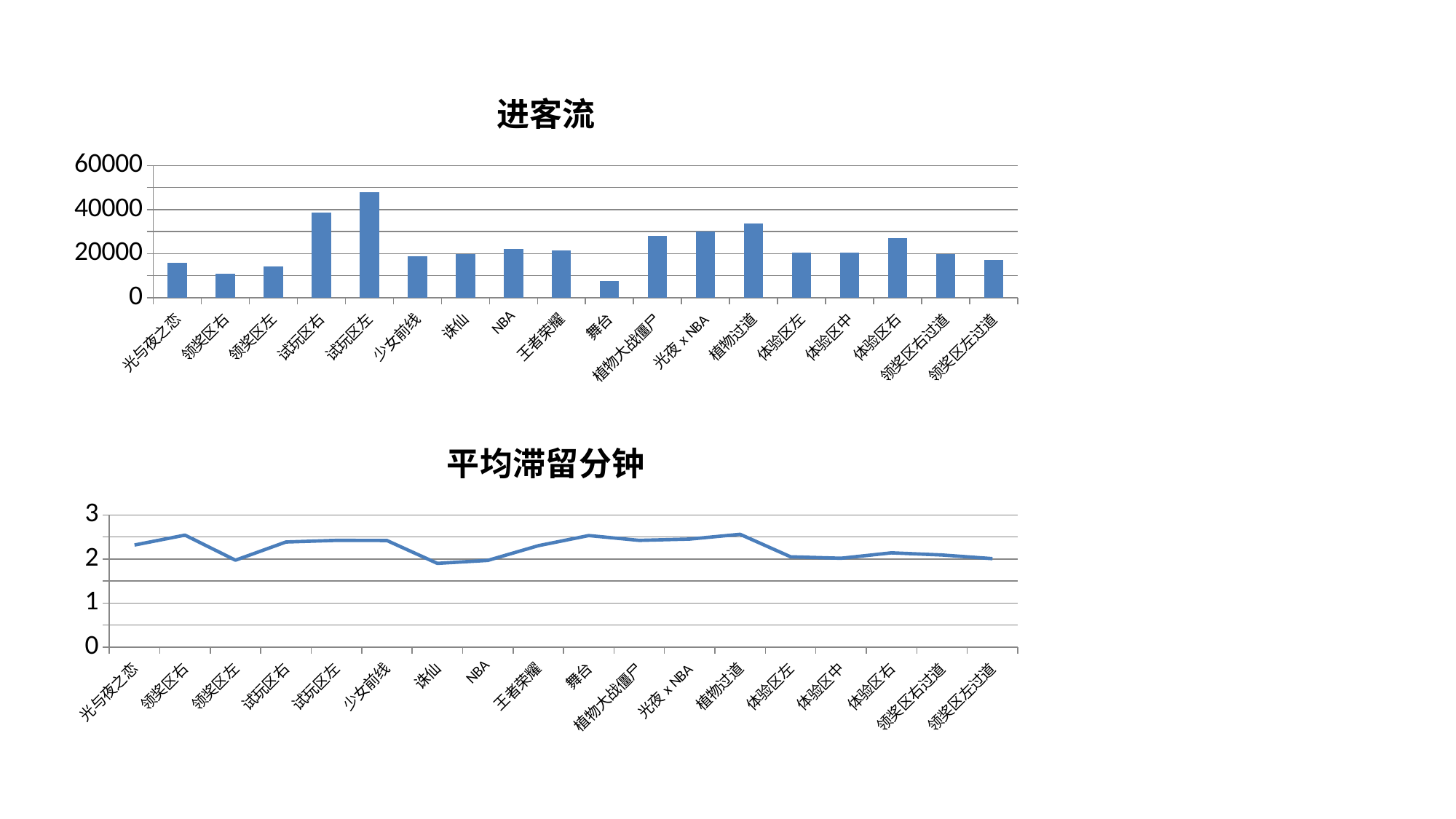
In the 进客流 chart, is the value for 试玩区右 greater or less than 20000? greater In the 平均滞留分钟 chart, is the value for 舞台 greater or less than 2? greater In the 进客流 chart, which category has the highest value? 试玩区左 In the 平均滞留分钟 chart, is the value for 诛仙 greater or less than 2? less What type of chart is the top chart titled 进客流? bar chart What type of chart is the bottom chart titled 平均滞留分钟? line chart In the 进客流 chart, which is larger, the value for 试玩区左 or the value for 试玩区右? 试玩区左 In the 平均滞留分钟 chart, which is larger, the value for 舞台 or the value for 诛仙? 舞台 In the 进客流 chart, which is larger, the value for 舞台 or the value for 领奖区右? 领奖区右 In the 进客流 chart, which category has the lowest value? 舞台 How many categories are shown on the x axis of the 进客流 chart? 18